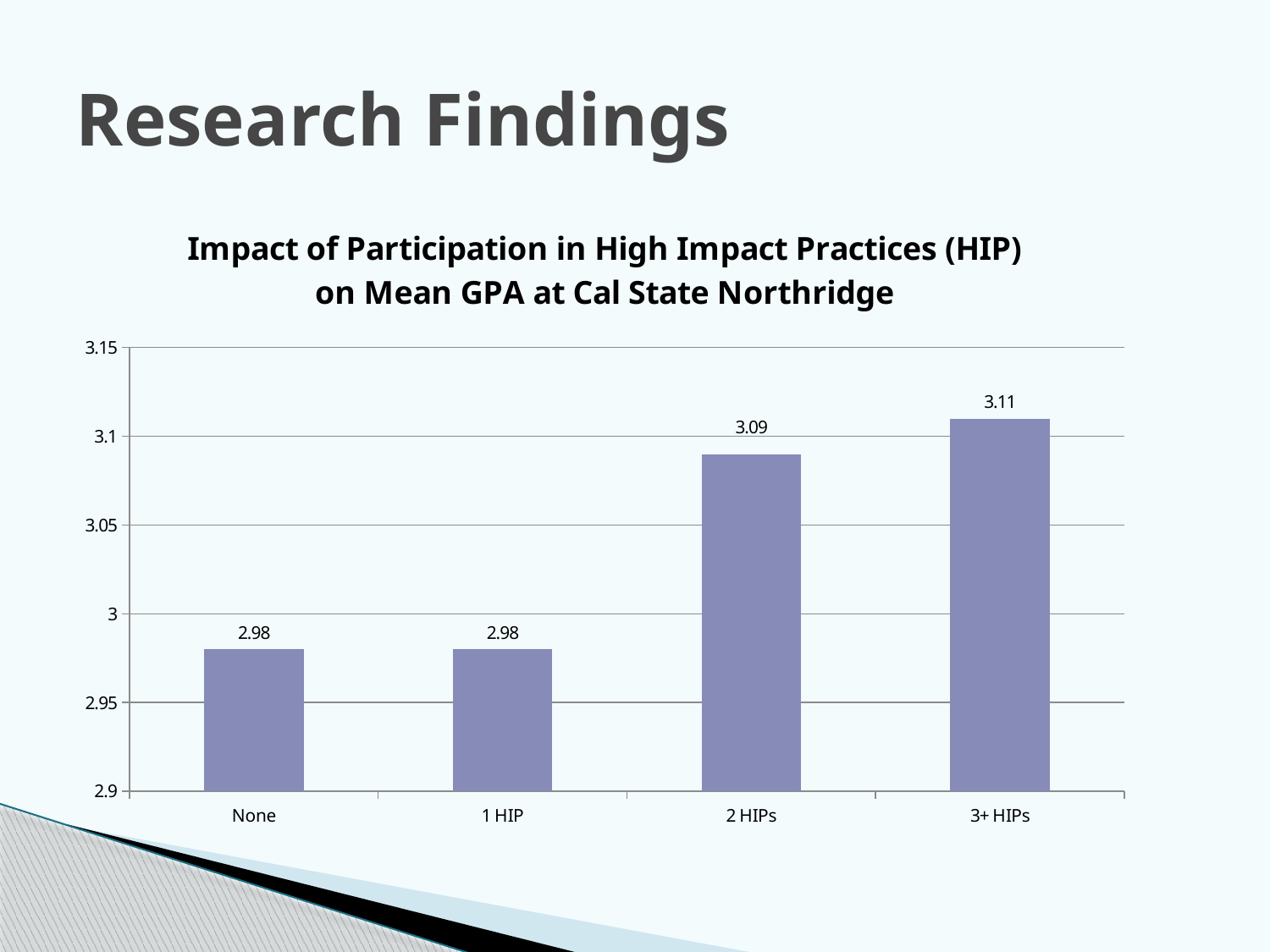
Which category has the highest mean GPA? 3+ HIPs What is the mean GPA for students with 2 HIPs? 3.09 Which is larger, the mean GPA for 2 HIPs or for 1 HIP? 2 HIPs What is the title of the chart? Impact of Participation in High Impact Practices (HIP) on Mean GPA at Cal State Northridge Is the mean GPA for 2 HIPs greater or less than 3.05? greater What is the mean GPA for students with 3+ HIPs? 3.11 Is the mean GPA for 1 HIP greater or less than 3? less What kind of chart is shown on the slide? Bar chart What is the difference in mean GPA between 2 HIPs and 1 HIP? 0.11 What is the difference in mean GPA between 3+ HIPs and None? 0.13 What is the mean GPA for students with no HIP participation (None)? 2.98 How many categories are shown on the x axis? 4